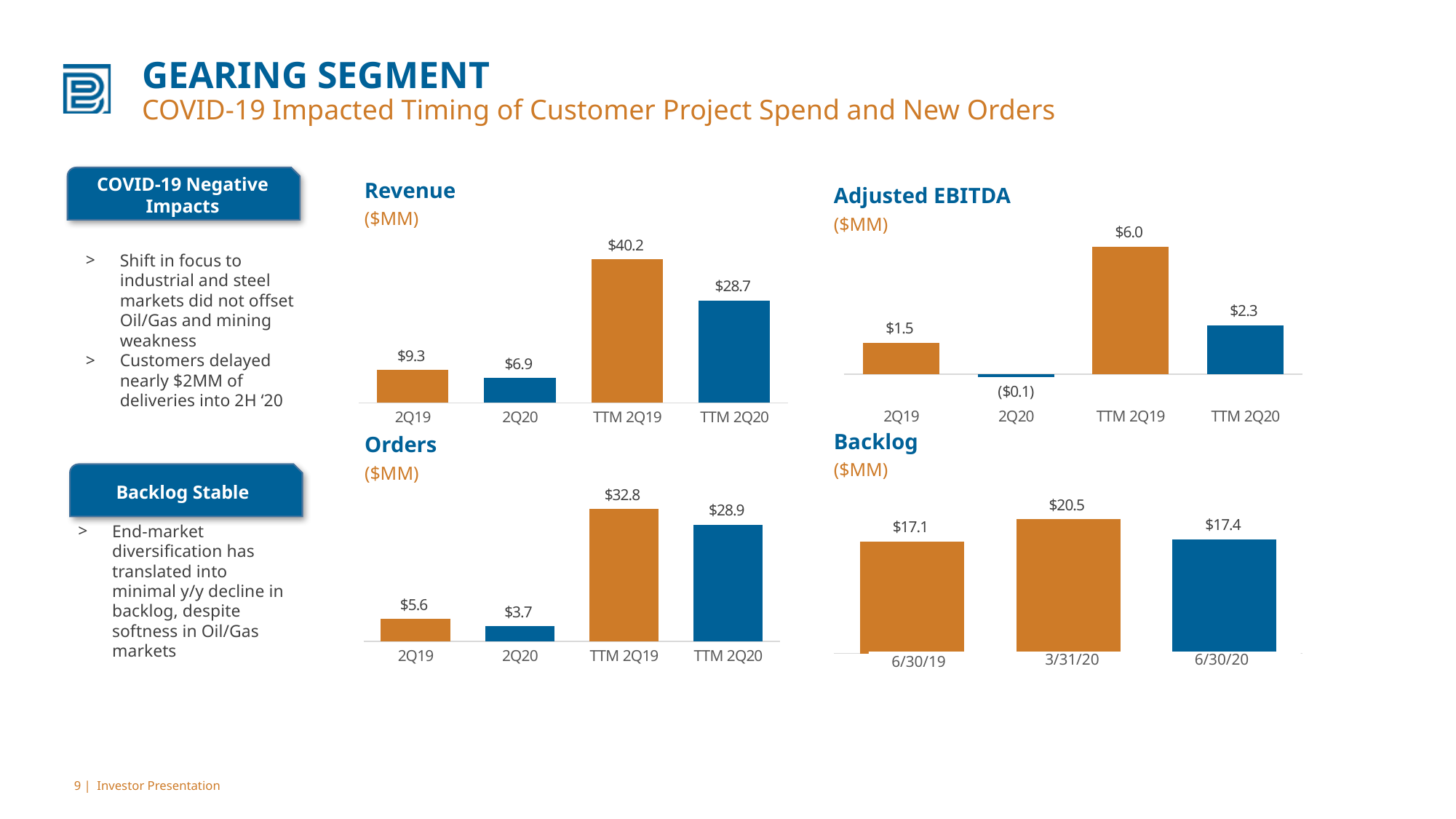
In the Adjusted EBITDA chart, which is larger, 2Q19 or TTM 2Q20? TTM 2Q20 In the Backlog chart, which date has the lowest value? 6/30/19 In the Orders chart, what is the difference between 2Q19 and 2Q20? $1.9 In the Revenue chart, what is the difference between TTM 2Q19 and TTM 2Q20? $11.5 In the Adjusted EBITDA chart, which category has the highest value? TTM 2Q19 In the Revenue chart, which category has the lowest value? 2Q20 In the Adjusted EBITDA chart, what is the value for 2Q20? ($0.1) In the Backlog chart, what is the value for 3/31/20? $20.5 In the Revenue chart, what is the value for TTM 2Q19? $40.2 What kind of chart is the Backlog chart? Bar chart In the Orders chart, what is the value for 2Q20? $3.7 How many bars are in the Orders chart? 4